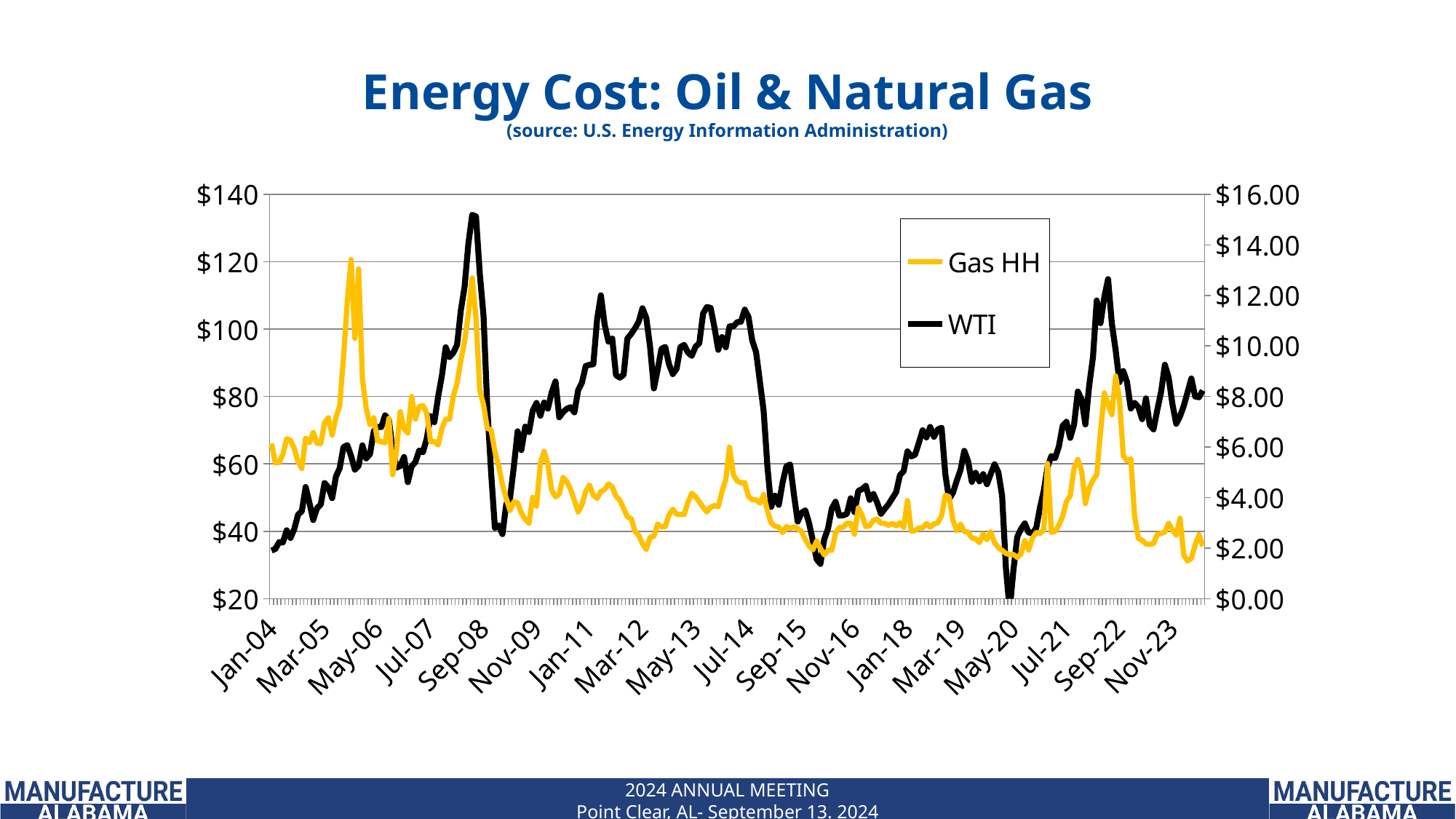
Around which x-axis label does the WTI series reach its highest point? Sep-08 What kind of chart is shown on the slide? line chart Does the Gas HH series rise or fall between Sep-22 and Nov-23? fall Is the WTI value at its peak around Sep-08 greater or less than $120 on the left axis? greater Is the WTI value around May-20 greater or less than $40 on the left axis? less How many series does the chart legend list? 2 Is the Gas HH value around Nov-23 greater or less than $4.00 on the right axis? less What is the title of the chart on the slide? Energy Cost: Oil & Natural Gas What are the two series named in the legend? Gas HH and WTI Around which x-axis label does the WTI series reach its lowest point? May-20 Does the WTI series rise or fall between Jul-14 and Sep-15? fall